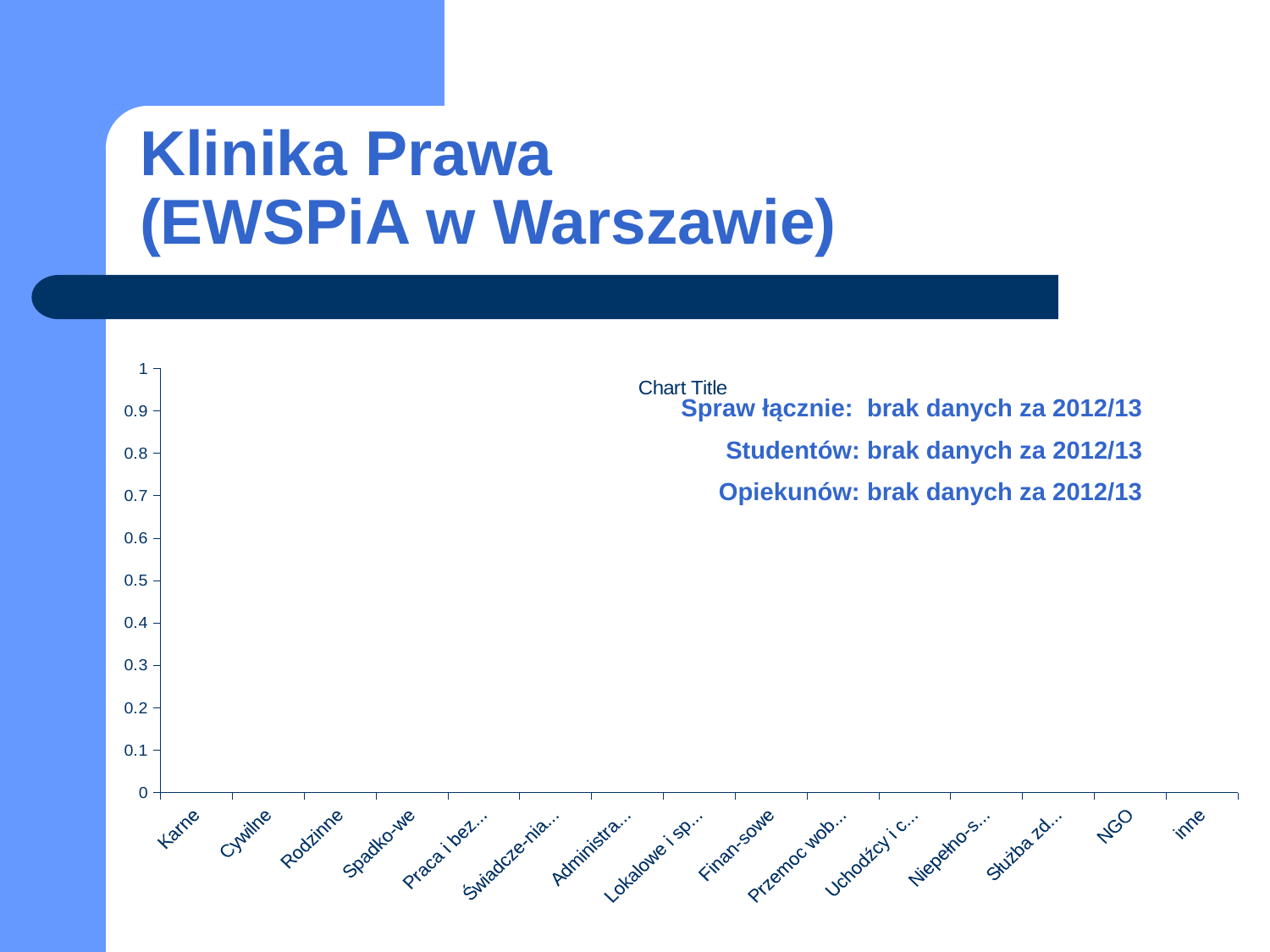
What is the lowest tick value shown on the y axis of the chart? 0 What is the highest tick value shown on the y axis of the chart? 1 What is the last category label on the x axis of the chart? inne What is the title shown on the chart? Chart Title Are any data bars or points plotted in the chart? No What is the step between consecutive tick values on the y axis of the chart? 0.1 What is the first category label on the x axis of the chart? Karne How many categories are listed along the x axis of the chart? 15